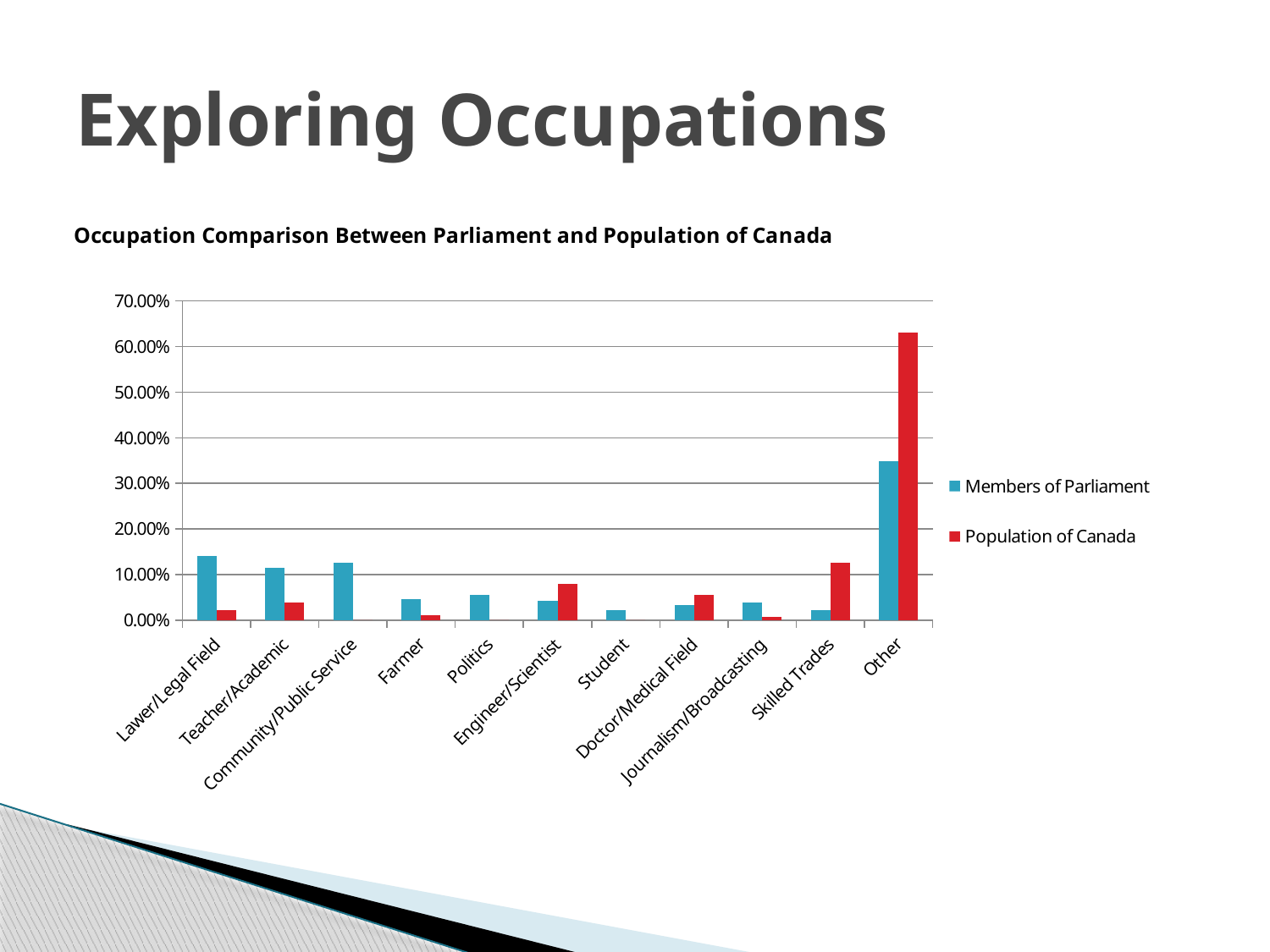
For Skilled Trades, which series has the larger value: Members of Parliament or Population of Canada? Population of Canada Is the Population of Canada value for Other greater or less than 60.00%? greater Is the Members of Parliament value for Lawer/Legal Field greater or less than 10.00%? greater How many series does the legend list? 2 For Engineer/Scientist, which series has the larger value: Members of Parliament or Population of Canada? Population of Canada What kind of chart is shown on the slide? bar chart How many occupation categories are shown on the x axis? 11 Which occupation category has the highest value for Members of Parliament? Other What is the title of the chart? Occupation Comparison Between Parliament and Population of Canada Is the Members of Parliament value for Other greater or less than 30.00%? greater Which occupation category has the highest value for Population of Canada? Other For Lawer/Legal Field, which series has the larger value: Members of Parliament or Population of Canada? Members of Parliament